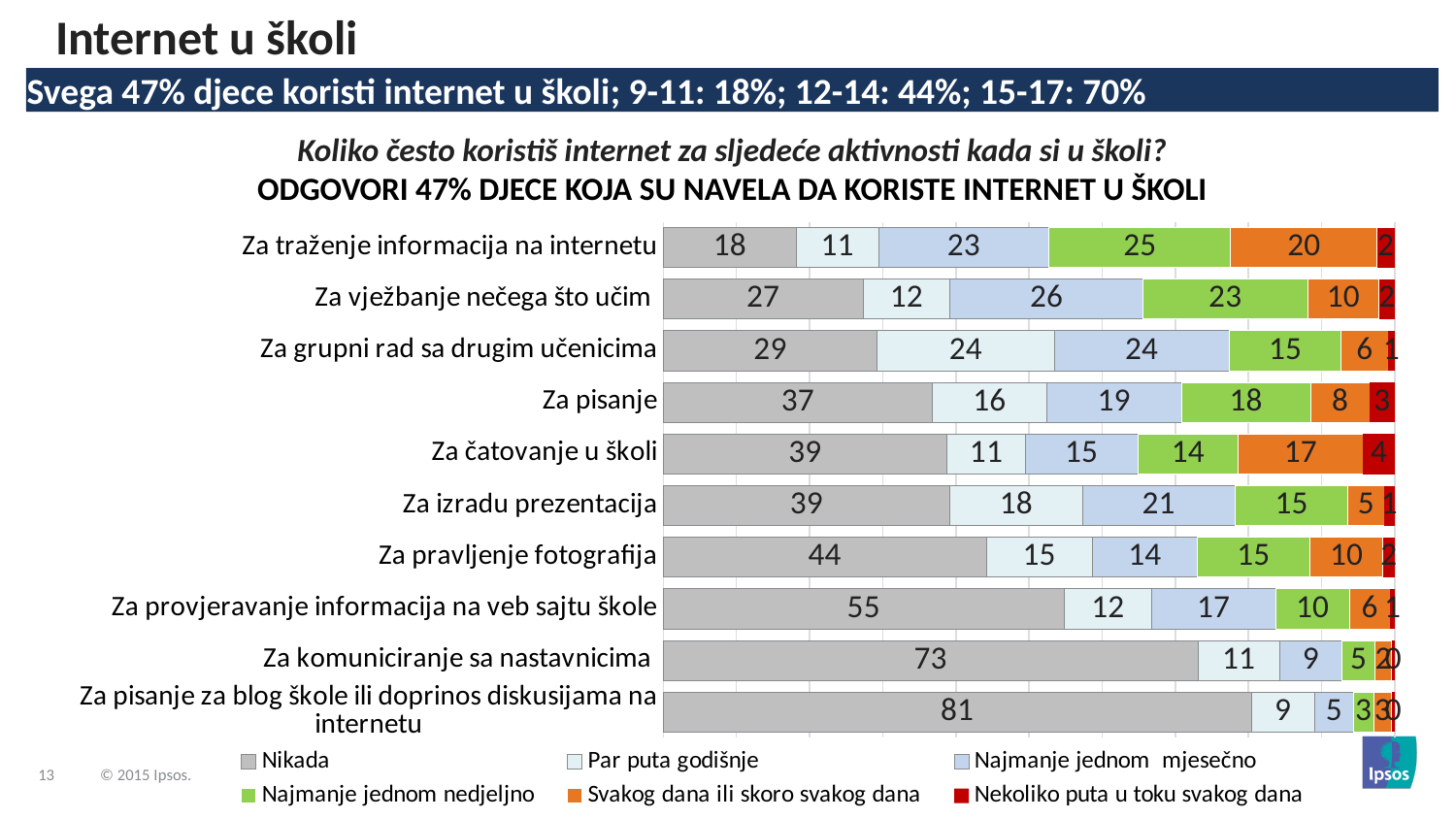
What is the difference between the 'Nikada' values for 'Za komuniciranje sa nastavnicima' and 'Za pravljenje fotografija'? 29 What is the total of the stacked bar for 'Za vježbanje nečega što učim'? 100 What is the 'Svakog dana ili skoro svakog dana' value for 'Za čatovanje u školi'? 17 Which activity has the highest 'Nikada' value? Za pisanje za blog škole ili doprinos diskusijama na internetu Which is larger: the 'Par puta godišnje' value for 'Za grupni rad sa drugim učenicima' or for 'Za izradu prezentacija'? Za grupni rad sa drugim učenicima How many series does the legend list? 6 What is the 'Nikada' value for 'Za pisanje'? 37 How many activity categories are plotted in the chart? 10 Which activity has the lowest 'Nikada' value? Za traženje informacija na internetu What type of chart is shown on the slide? stacked bar chart What is the 'Najmanje jednom nedjeljno' value for 'Za traženje informacija na internetu'? 25 Which legend entry is shown in red? Nekoliko puta u toku svakog dana